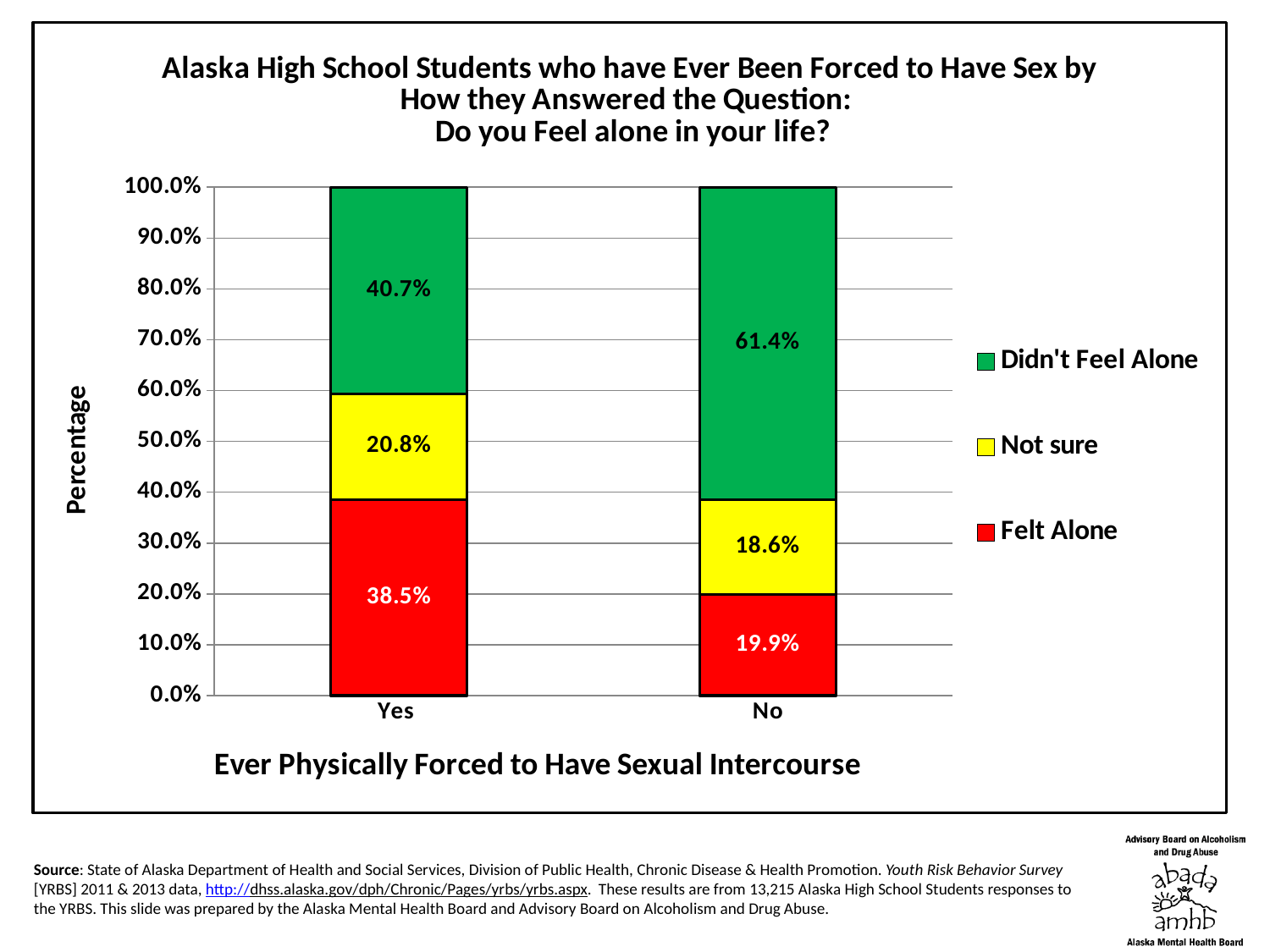
What is the Not sure value for the No category? 18.6% Which colour represents the Felt Alone series? Red What is the difference between the Felt Alone percentages for Yes and No? 18.6% How many categories are shown on the x axis? 2 How many series does the legend list? 3 What percentage of students who answered No didn't feel alone? 61.4% What is the label of the x axis? Ever Physically Forced to Have Sexual Intercourse What is the Not sure value for the Yes category? 20.8% Which category has the higher Felt Alone percentage, Yes or No? Yes What percentage of students who answered Yes felt alone? 38.5% What kind of chart is shown on the slide? Stacked bar chart What is the difference between the Didn't Feel Alone percentages for No and Yes? 20.7%